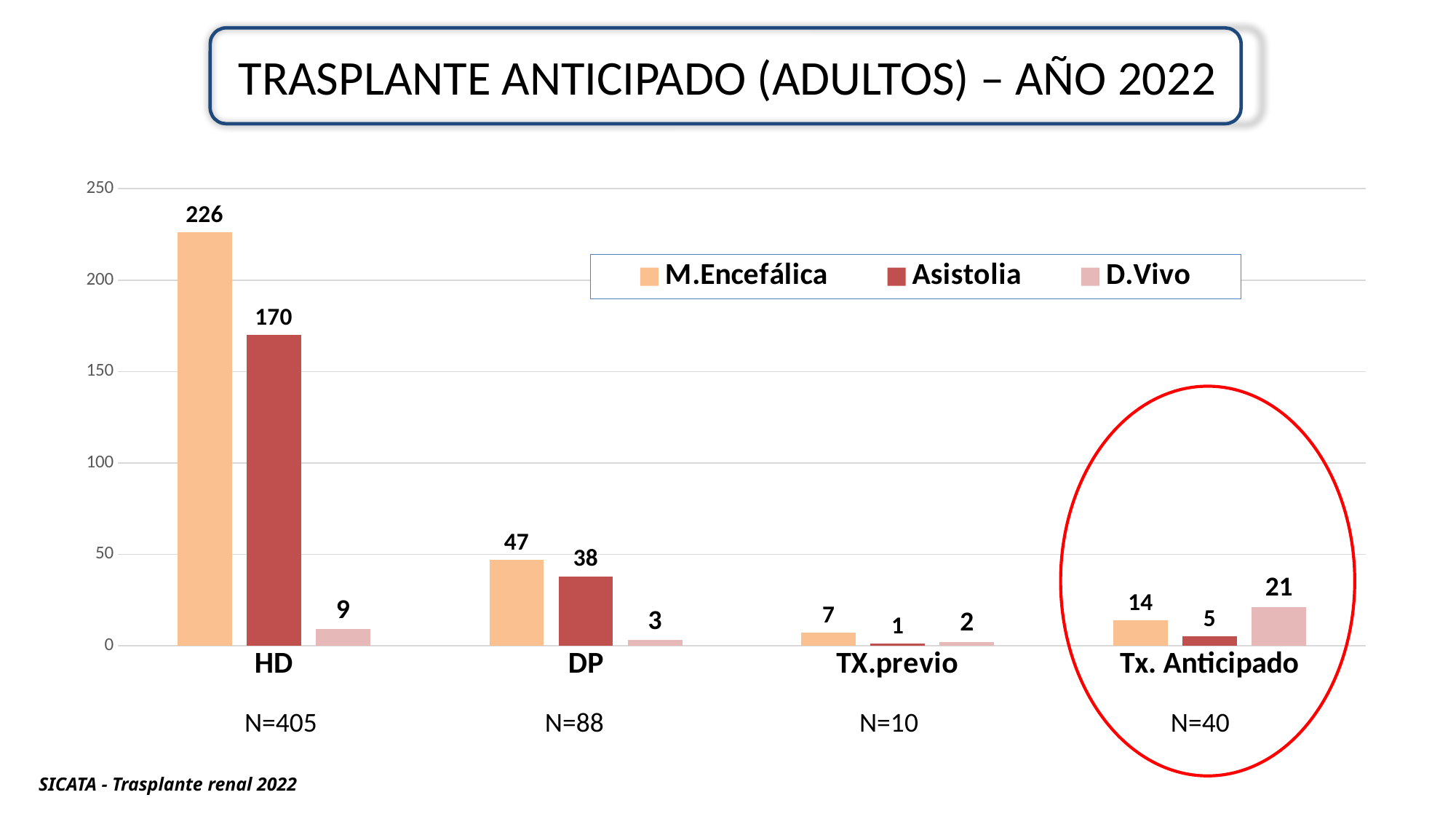
How many series does the legend list? 3 What is the value for Asistolia in the DP category? 38 What is the value for M.Encefálica in the HD category? 226 Which category has the lowest M.Encefálica value? TX.previo Which category has the highest Asistolia value? HD What is the N value shown under the Tx. Anticipado category? N=40 What kind of chart is shown on the slide? Bar chart In the Tx. Anticipado category, which is larger: M.Encefálica or D.Vivo? D.Vivo What is the value for D.Vivo in the Tx. Anticipado category? 21 How many categories are shown on the x axis? 4 What is the difference between the M.Encefálica and Asistolia values in the HD category? 56 Is the value for Asistolia in HD greater or less than 150? greater